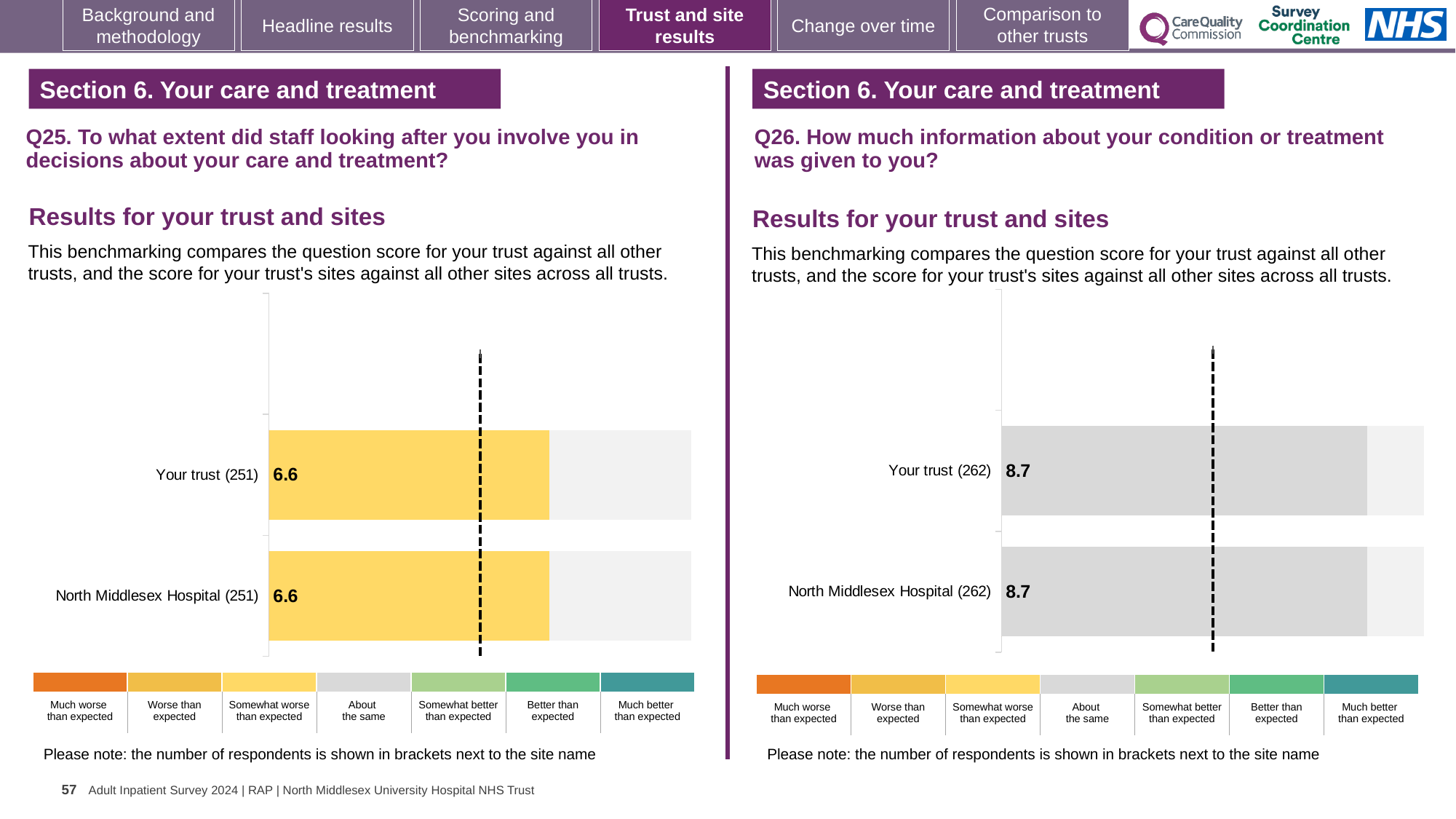
In the Q26 chart on the right, which benchmark category does the colour of the bars correspond to according to the legend? About the same How many bars are plotted in the Q25 chart on the left? 2 In the Q26 chart on the right, what is the score for Your trust (262)? 8.7 How many respondents are shown in brackets for Your trust in the Q26 chart on the right? 262 What kind of chart is used for the Q25 results on the left? Bar chart In the Q26 chart on the right, what is the difference between the score for Your trust and the score for North Middlesex Hospital? 0 How many bars are plotted in the Q26 chart on the right? 2 In the Q26 chart on the right, what is the score for North Middlesex Hospital (262)? 8.7 In the Q25 chart on the left, what is the difference between the score for Your trust and the score for North Middlesex Hospital? 0 In the Q25 chart on the left, what is the score for Your trust (251)? 6.6 In the Q25 chart on the left, which benchmark category does the colour of the bars correspond to according to the legend? Somewhat worse than expected In the Q25 chart on the left, what is the score for North Middlesex Hospital (251)? 6.6